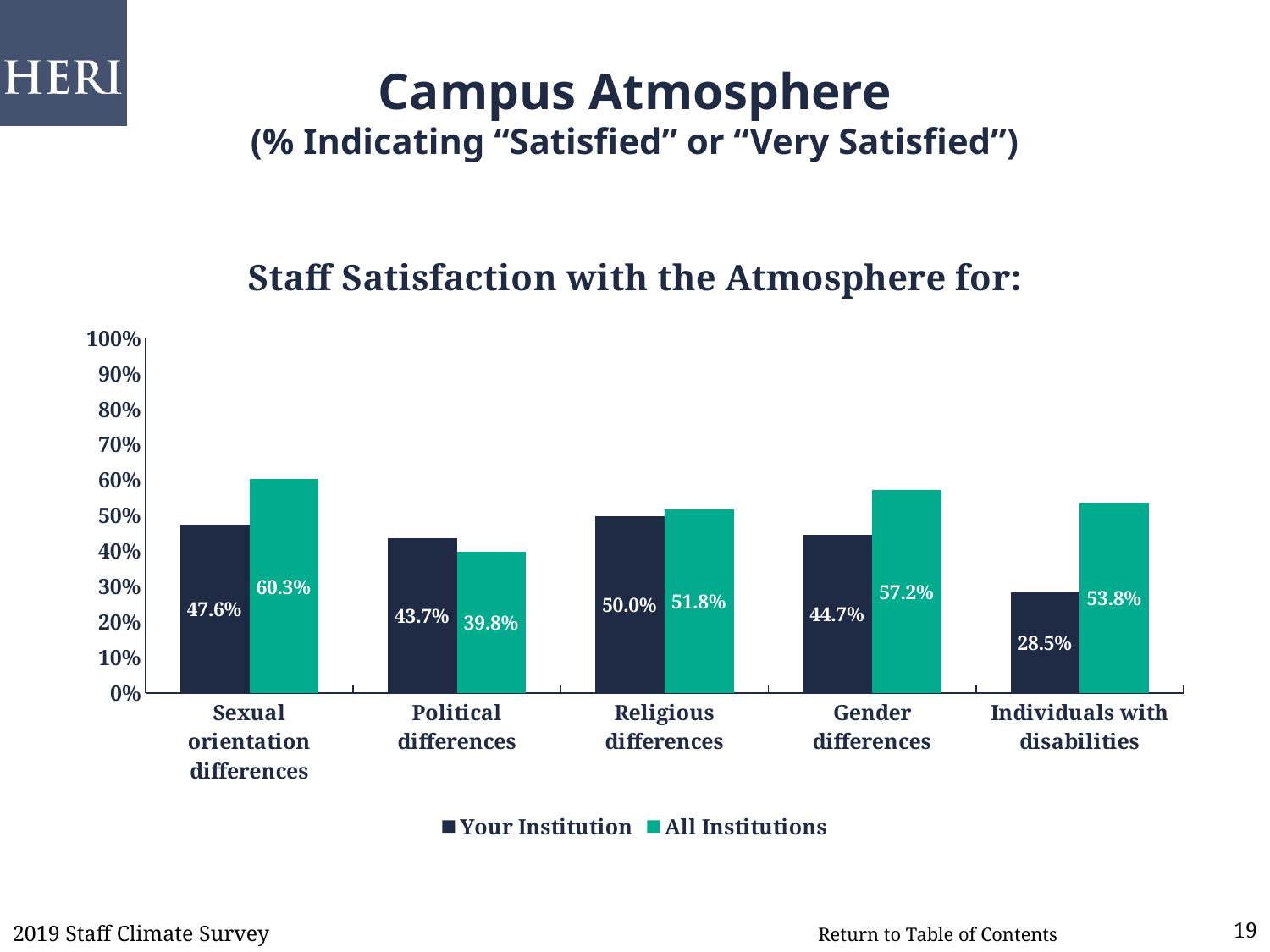
Is the value for All Institutions for Gender differences greater or less than 50%? greater What is the difference between All Institutions and Your Institution for Individuals with disabilities? 25.3% What is the value for Your Institution for Individuals with disabilities? 28.5% What is the value for Your Institution for Religious differences? 50.0% Which category has the highest value for All Institutions? Sexual orientation differences What is the title of the chart? Staff Satisfaction with the Atmosphere for: How many series does the legend list? 2 Which is larger for Political differences: Your Institution or All Institutions? Your Institution Which category has the lowest value for Your Institution? Individuals with disabilities How many categories are shown on the x axis? 5 What kind of chart is shown on the slide? Bar chart What is the value for All Institutions for Sexual orientation differences? 60.3%